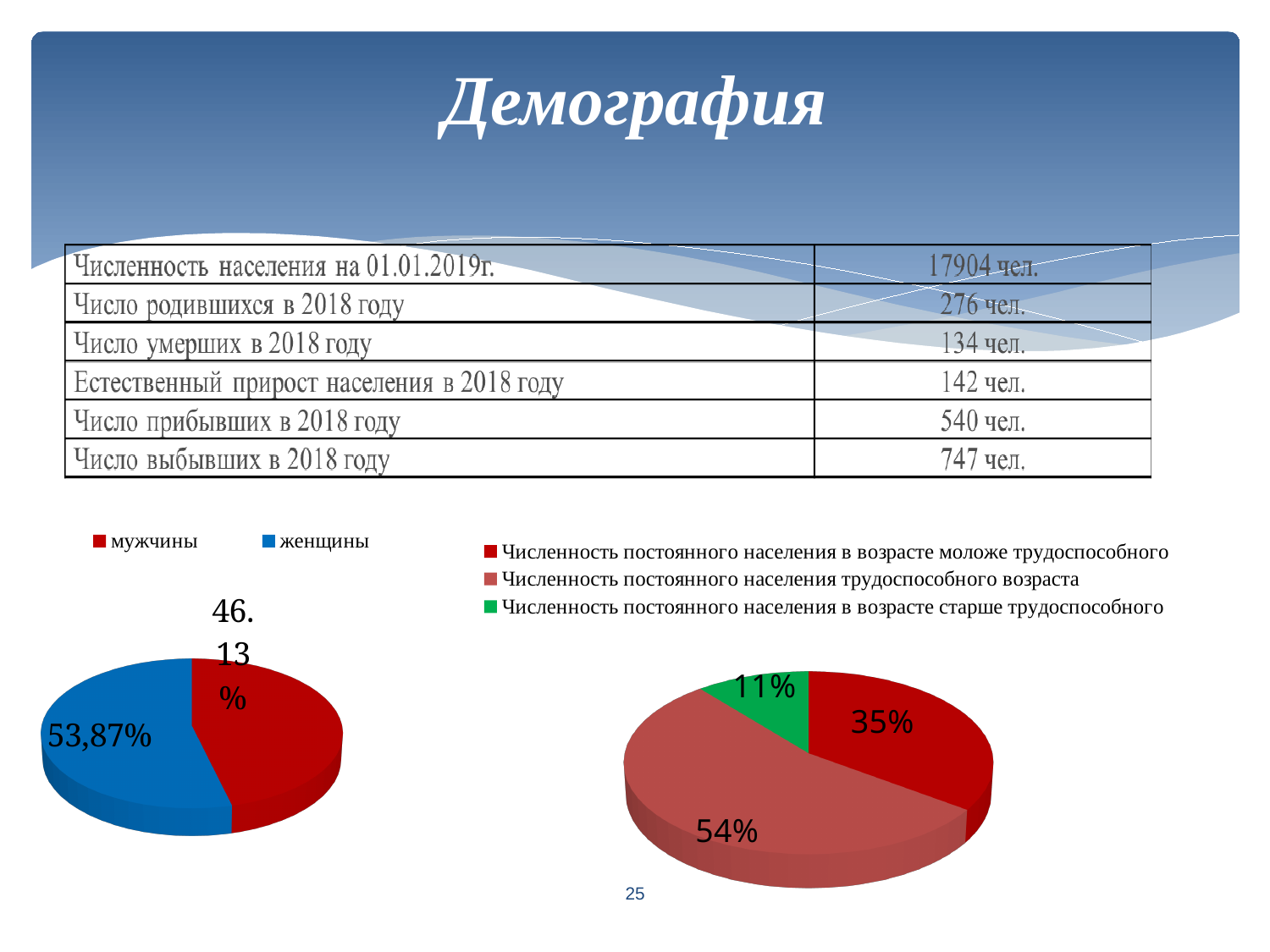
In the right pie chart, what share is shown for Численность постоянного населения в возрасте моложе трудоспособного? 35% What kind of chart is the left chart on the slide? pie chart In the right pie chart, what share is shown for Численность постоянного населения трудоспособного возраста? 54% In the right pie chart, what is the difference in percentage points between the share of working-age population (54%) and the share younger than working age (35%)? 19 In the right pie chart, which category has the largest share? Численность постоянного населения трудоспособного возраста How many entries does the legend of the left pie chart list? 2 In the left pie chart, what share is shown for женщины? 53,87% In the left pie chart, what share is shown for мужчины? 46.13% In the right pie chart, which category has the smallest share? Численность постоянного населения в возрасте старше трудоспособного In the left pie chart, what colour is the slice for мужчины? red In the right pie chart, what share is shown for Численность постоянного населения в возрасте старше трудоспособного? 11% In the left pie chart, which category has the larger share, мужчины or женщины? женщины